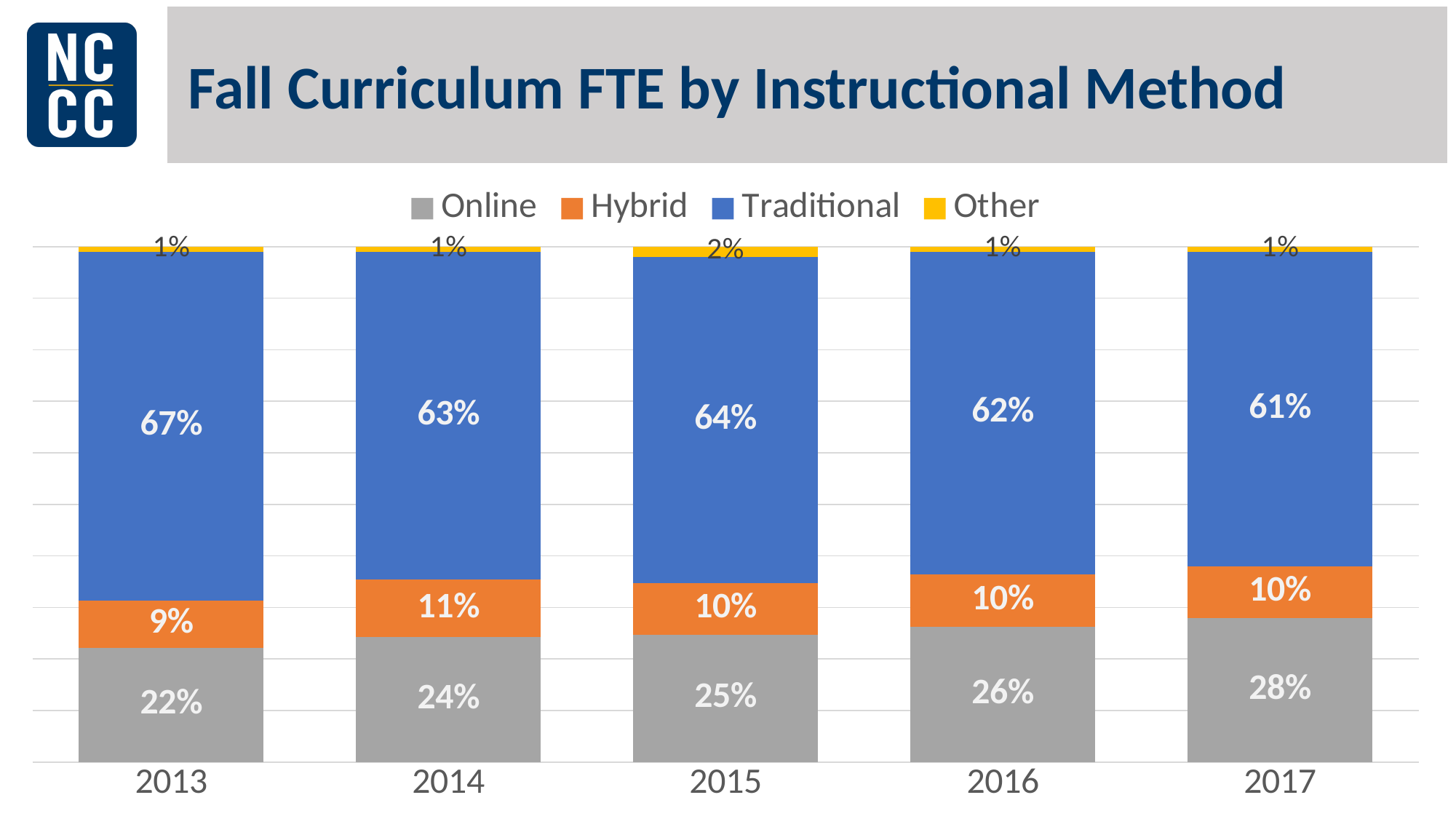
What is the difference between the Traditional share in 2013 and in 2017? 6% What kind of chart is shown? Stacked bar chart Which is larger, the Online share in 2016 or the Online share in 2014? 2016 What is the Online share in 2017? 28% In which year is the Traditional share highest? 2013 In which year is the Online share lowest? 2013 How many years are shown on the x axis? 5 Does the Online share rise or fall from 2013 to 2017? Rise What is the Other share in 2015? 2% How many series does the legend list? 4 What is the Traditional share in 2013? 67% What is the Hybrid share in 2014? 11%